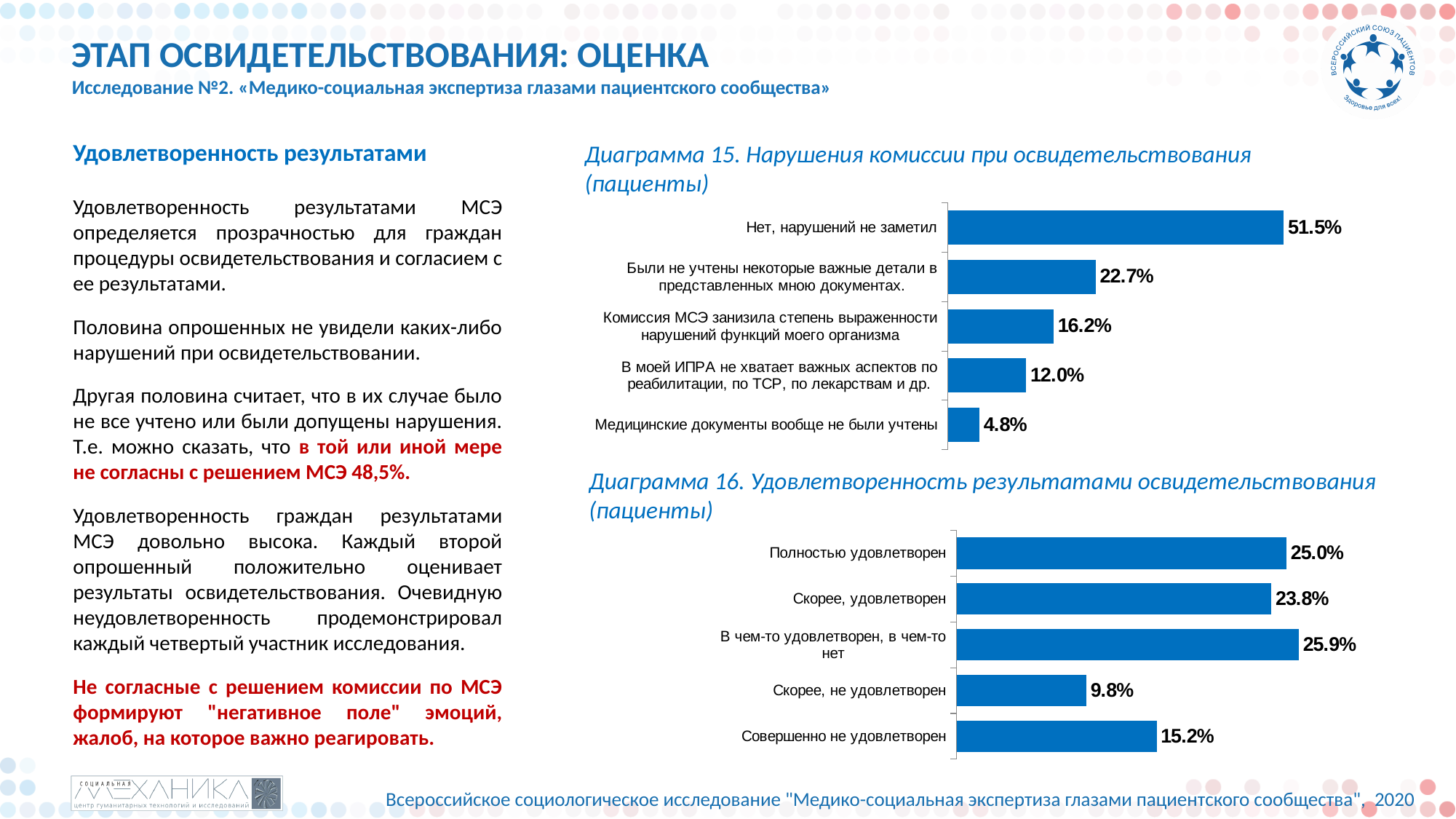
In Диаграмма 15, how many categories are shown? 5 In Диаграмма 16, which category has the lowest value? Скорее, не удовлетворен In Диаграмма 16, which category has the highest value? В чем-то удовлетворен, в чем-то нет What type of chart is Диаграмма 15? Bar chart In Диаграмма 15, what is the value for «Медицинские документы вообще не были учтены»? 4.8% In Диаграмма 16, what is the value for «Скорее, удовлетворен»? 23.8% In Диаграмма 16, what is the difference between «Полностью удовлетворен» and «Совершенно не удовлетворен»? 9.8% What is the title of the lower chart on the slide? Диаграмма 16. Удовлетворенность результатами освидетельствования (пациенты) In Диаграмма 15, which category has the lowest value? Медицинские документы вообще не были учтены In Диаграмма 15, what is the difference between «Были не учтены некоторые важные детали в представленных мною документах» and «Комиссия МСЭ занизила степень выраженности нарушений функций моего организма»? 6.5% In Диаграмма 16, which is larger: «Совершенно не удовлетворен» or «Скорее, не удовлетворен»? Совершенно не удовлетворен In Диаграмма 15, what percentage of patients answered «Нет, нарушений не заметил»? 51.5%